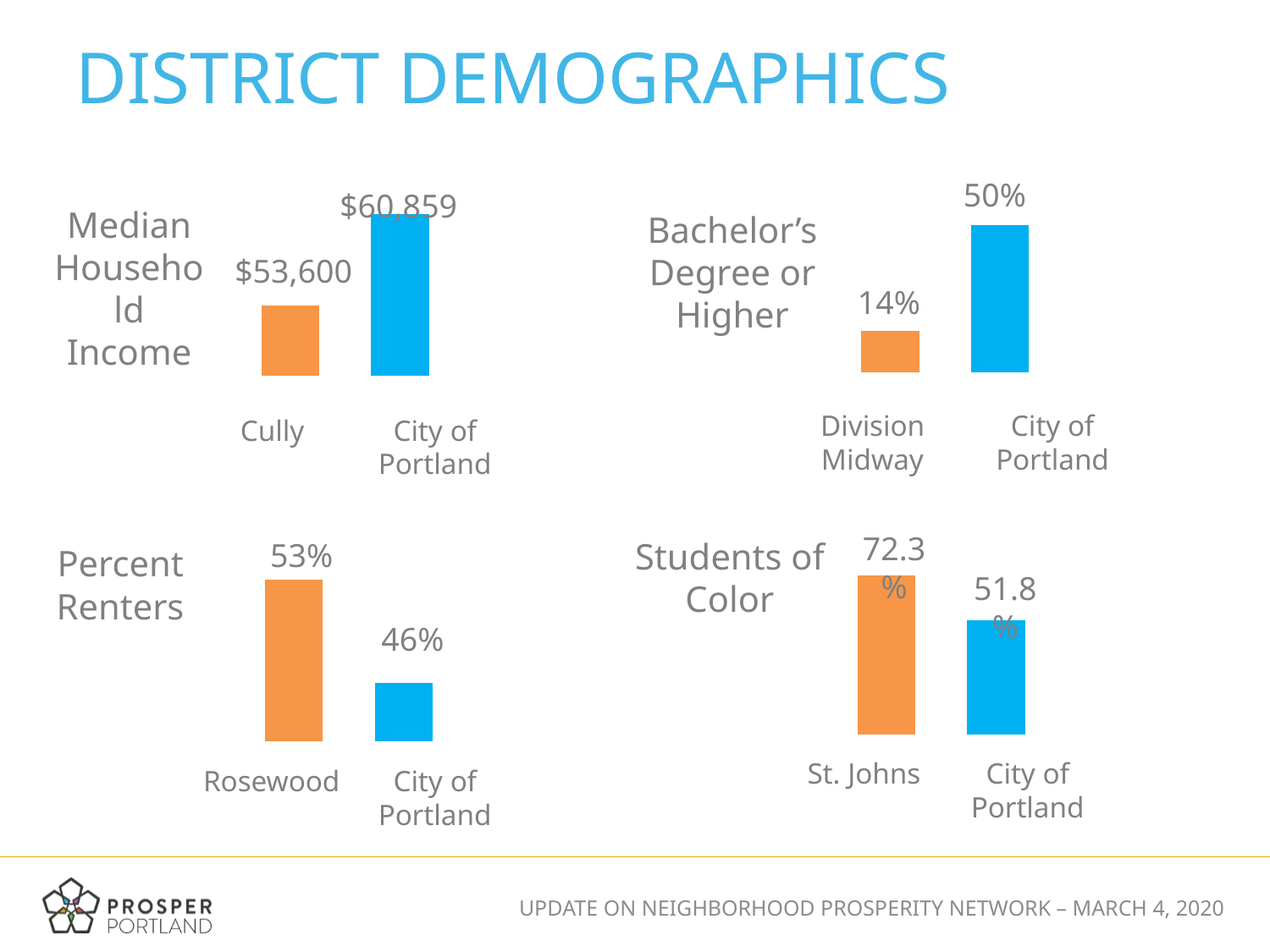
In the Median Household Income chart, what is the value for City of Portland? $60,859 In the Bachelor's Degree or Higher chart, what is the difference between City of Portland and Division Midway? 36% How many categories does the Students of Color chart show? 2 In the Students of Color chart, what is the value for St. Johns? 72.3% In the Median Household Income chart, what is the value for Cully? $53,600 In the Percent Renters chart, which is larger, Rosewood or City of Portland? Rosewood In the Median Household Income chart, what is the difference between City of Portland and Cully? $7,259 In the Students of Color chart, what is the value for City of Portland? 51.8% What kind of chart is the Percent Renters chart? Bar chart In the Percent Renters chart, what is the value for Rosewood? 53% In the Bachelor's Degree or Higher chart, which category is highest? City of Portland In the Bachelor's Degree or Higher chart, what is the value for Division Midway? 14%